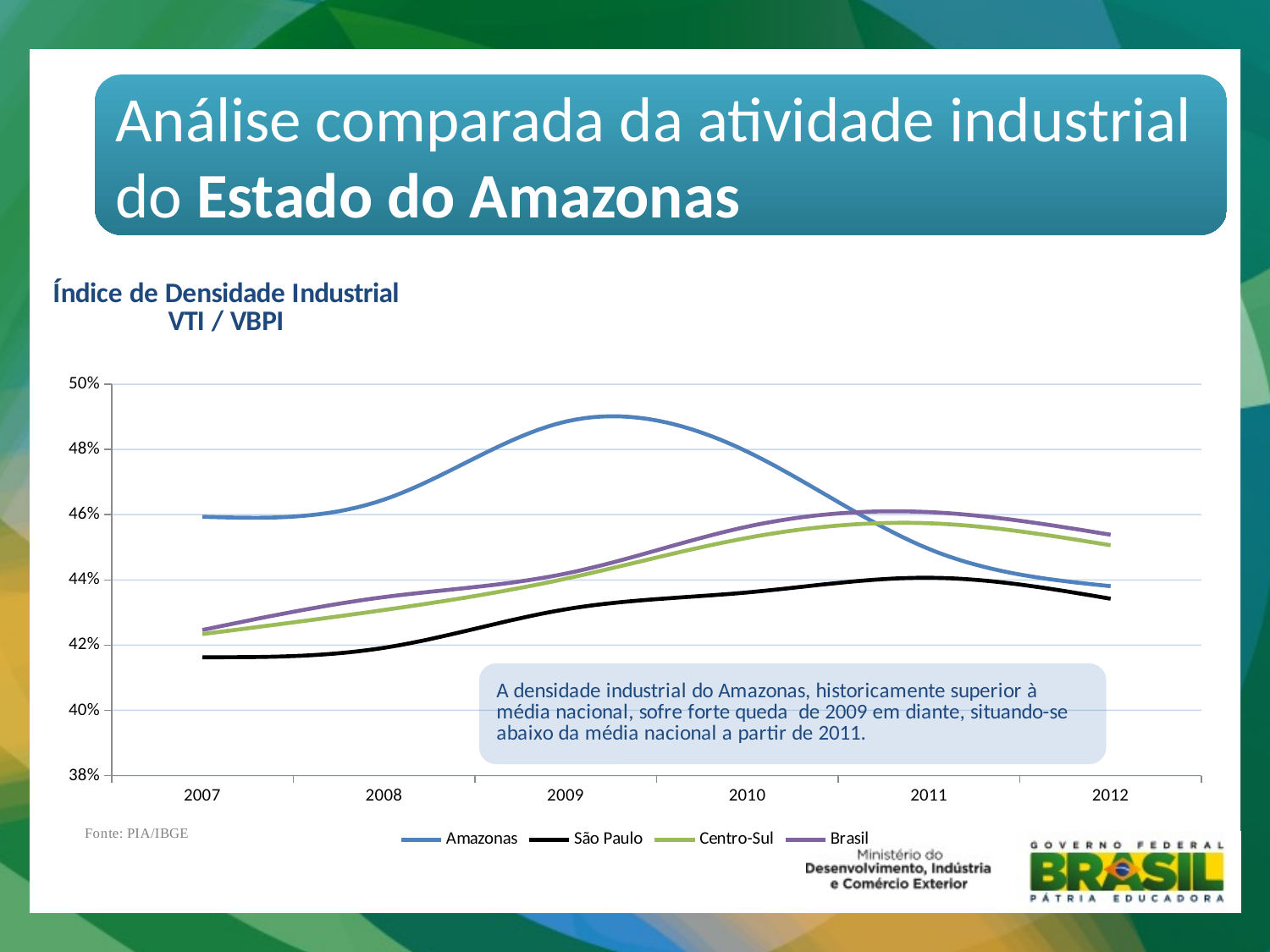
In 2007, which is larger: the value for Amazonas or the value for São Paulo? Amazonas In 2012, which is larger: the value for Brasil or the value for Amazonas? Brasil Does the Amazonas line rise or fall from 2009 to 2012? fall What is the source cited below the chart? PIA/IBGE How many years are shown on the x axis? 6 Is the value for São Paulo in 2007 greater or less than 42%? less How many series does the legend list? 4 Which series has the highest value in 2009? Amazonas Is the value for Centro-Sul in 2007 greater or less than 44%? less Is the value for Amazonas in 2009 greater or less than 48%? greater Which series has the lowest value in 2007? São Paulo What kind of chart is shown on the slide? line chart